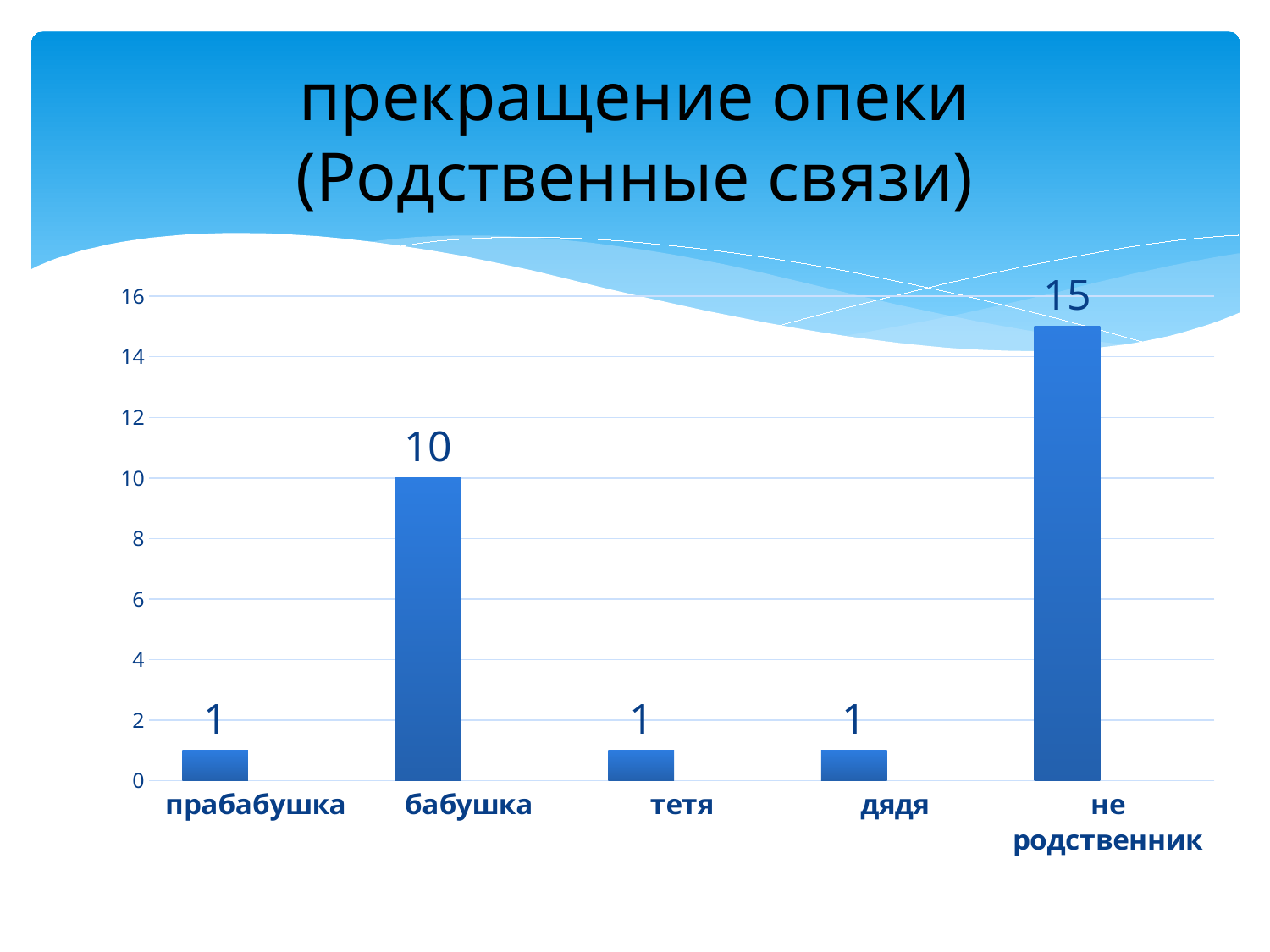
How many categories are shown on the x axis? 5 What is the highest value shown on the y axis? 16 Which category has the highest value? не родственник What is the value for прабабушка? 1 What is the total of the values for тетя and дядя? 2 What is the value for бабушка? 10 Which is larger, the value for бабушка or the value for тетя? бабушка What is the value for не родственник? 15 Is the value for не родственник greater or less than 14? greater What is the difference between the values for не родственник and бабушка? 5 What kind of chart is shown on the slide? bar chart What is the title of the slide? прекращение опеки (Родственные связи)